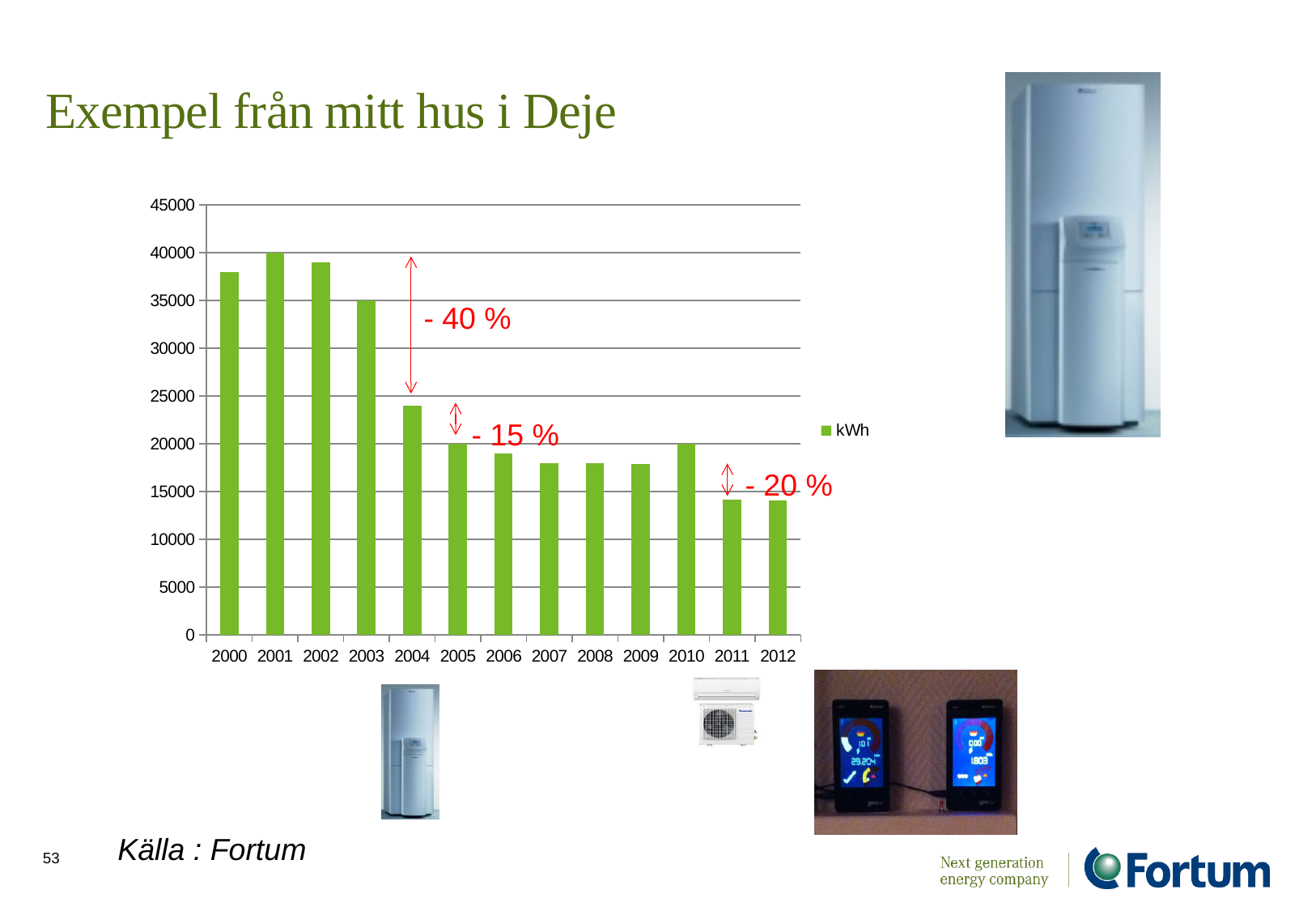
How many years are shown on the x axis of the chart? 13 What kind of chart is shown on the slide? bar chart Is the value for 2007 greater or less than 20000? less How many series does the chart legend list? 1 Is the value for 2004 greater or less than 20000? greater What percentage change is annotated in red between the 2003 and 2004 bars? - 40 % Which year has the highest value in the chart? 2001 Is the value for 2003 greater or less than 30000? greater Which year has the larger value, 2000 or 2004? 2000 What is the name of the series shown in the chart legend? kWh Do the values generally rise or fall from 2000 to 2012? fall